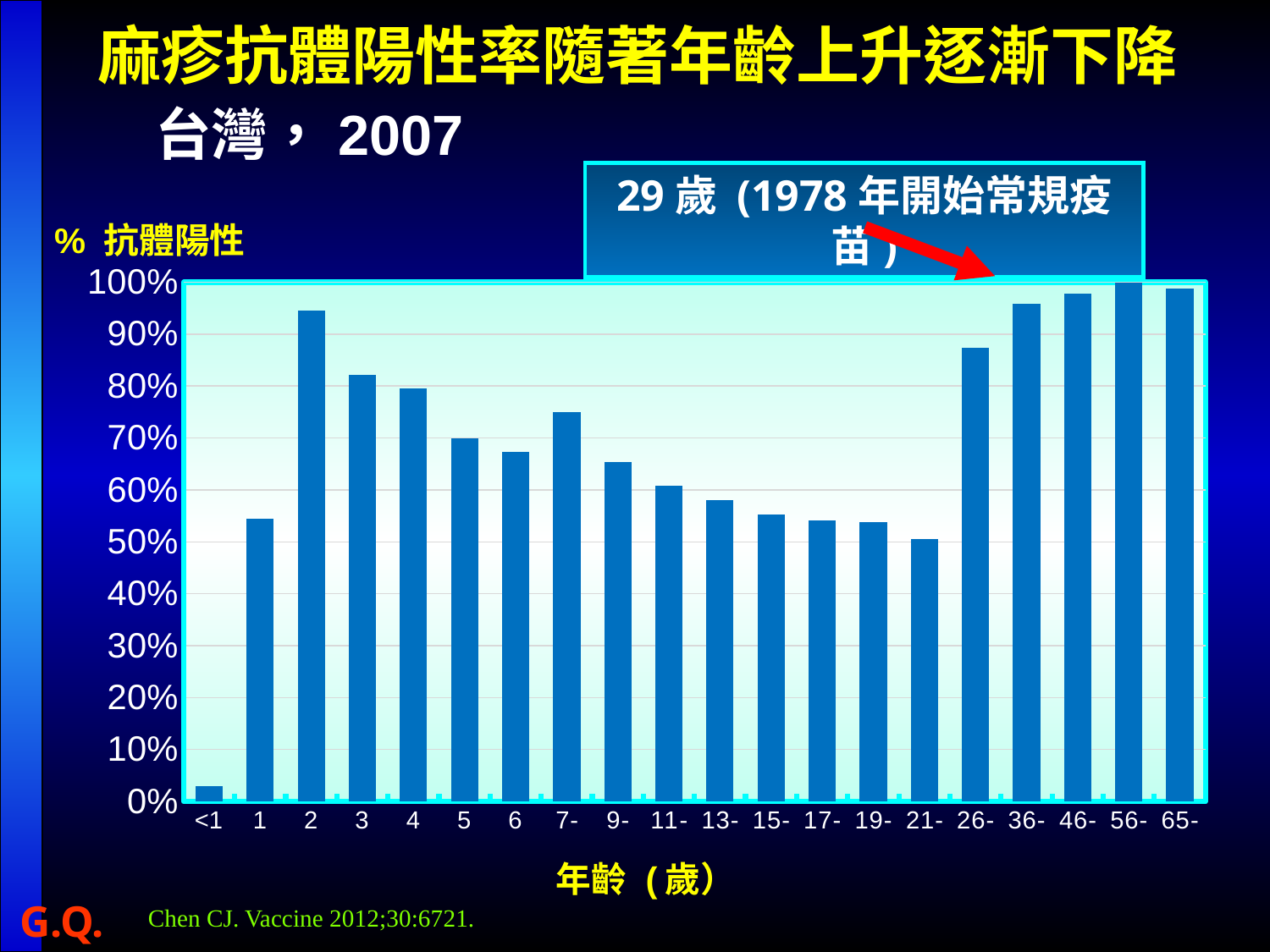
Do the values rise or fall from age 2 through age group 21-? fall How many age categories are shown on the x axis of the chart? 20 What kind of chart is shown on the slide? bar chart Is the value for age <1 greater or less than 10%? less Is the value for age group 26- greater or less than 80%? greater Is the value for age 2 greater or less than 90%? greater Which has a higher antibody positivity rate, age 2 or age 3? age 2 What is the x-axis title of the chart? 年齡（歲） Which has a higher antibody positivity rate, age 6 or age group 7-? 7- Which age category has the lowest antibody positivity rate? <1 What year does the annotation box say routine vaccination began? 1978